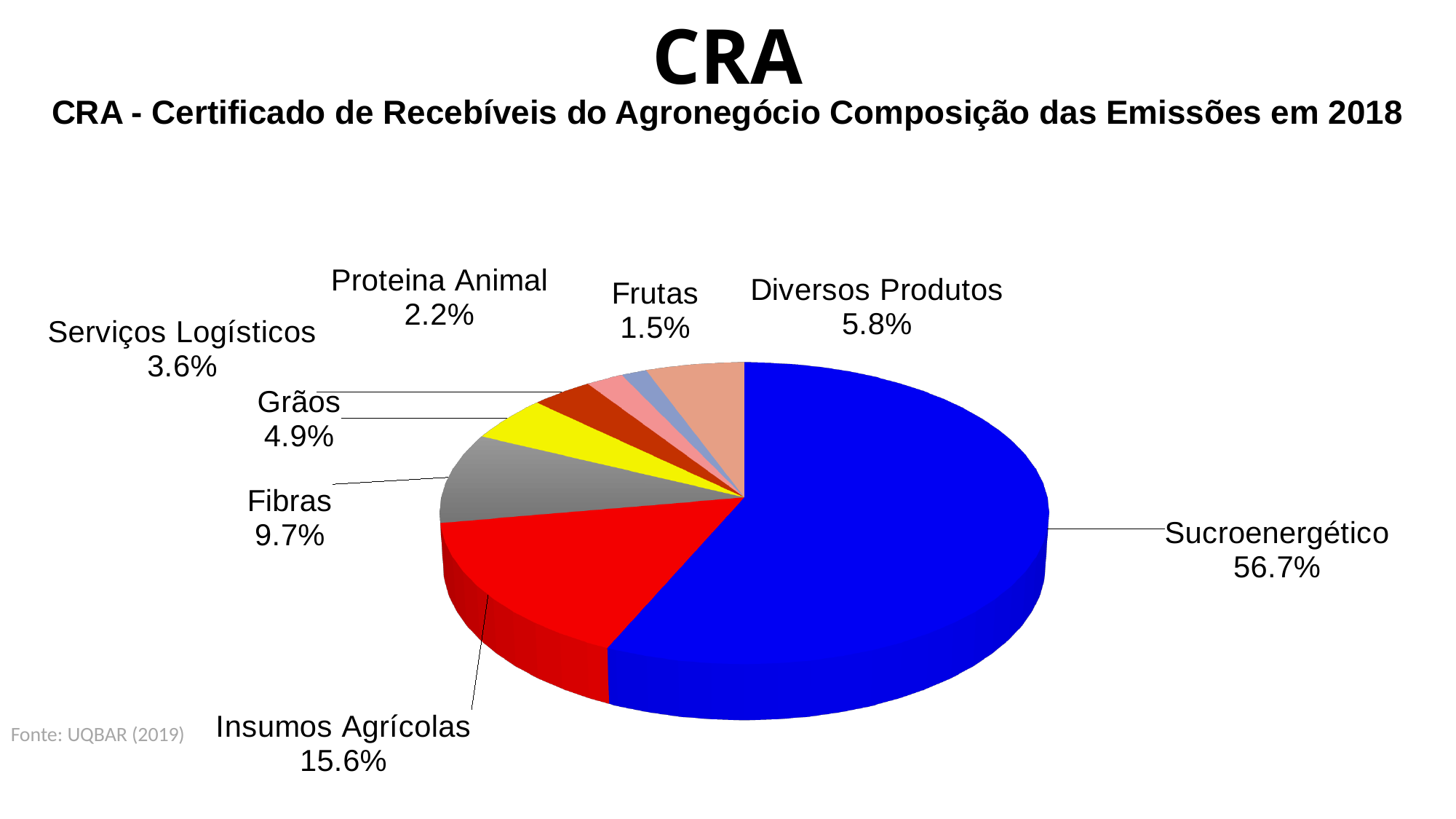
How many categories are shown in the pie chart? 8 What is the value shown for Fibras? 9.7% What is the difference between the shares of Proteina Animal and Frutas? 0.7% What kind of chart is shown on the slide? Pie chart What is the difference between the shares of Insumos Agrícolas and Fibras? 5.9% What colour is the Sucroenergético slice? Blue What is the value shown for Insumos Agrícolas? 15.6% What share of the pie does Sucroenergético represent? 56.7% Which category has the largest slice of the pie? Sucroenergético Which category has the smallest slice of the pie? Frutas Which is larger, Grãos or Serviços Logísticos? Grãos What is the value shown for Diversos Produtos? 5.8%